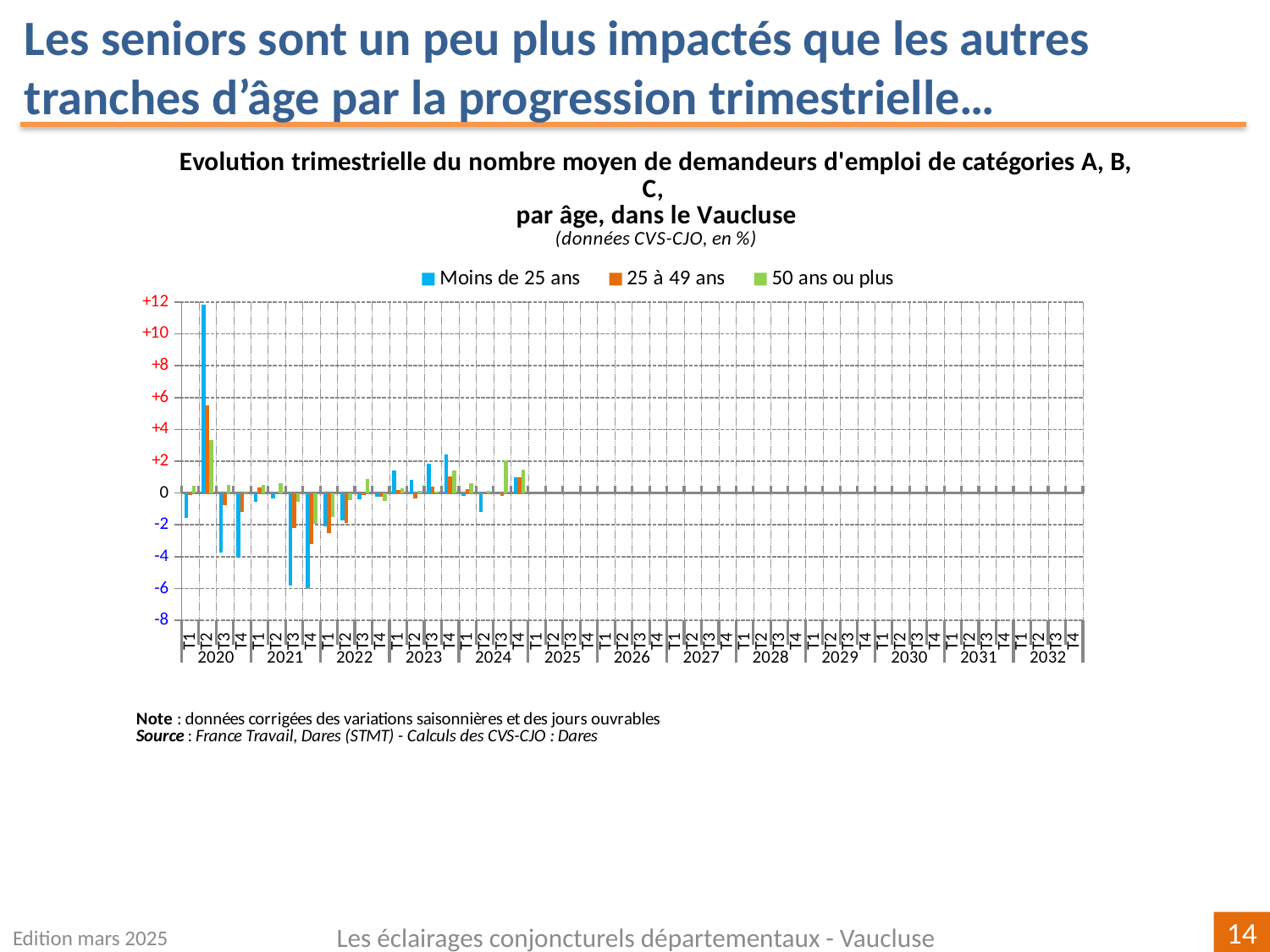
Is the value for Moins de 25 ans in T3 2021 greater or less than -4? less Is the value for Moins de 25 ans in T2 2020 greater or less than +10? greater In which quarter does the highest bar on the chart occur? T2 2020 Is the value for 50 ans ou plus in T2 2020 greater or less than +2? greater In T2 2020, which is larger: the value for Moins de 25 ans or the value for 25 à 49 ans? Moins de 25 ans How many series does the legend list? 3 What kind of chart is shown on the slide? bar chart Which series is shown in green in the legend? 50 ans ou plus Which series is shown in blue in the legend? Moins de 25 ans Which series has the highest bar on the chart? Moins de 25 ans